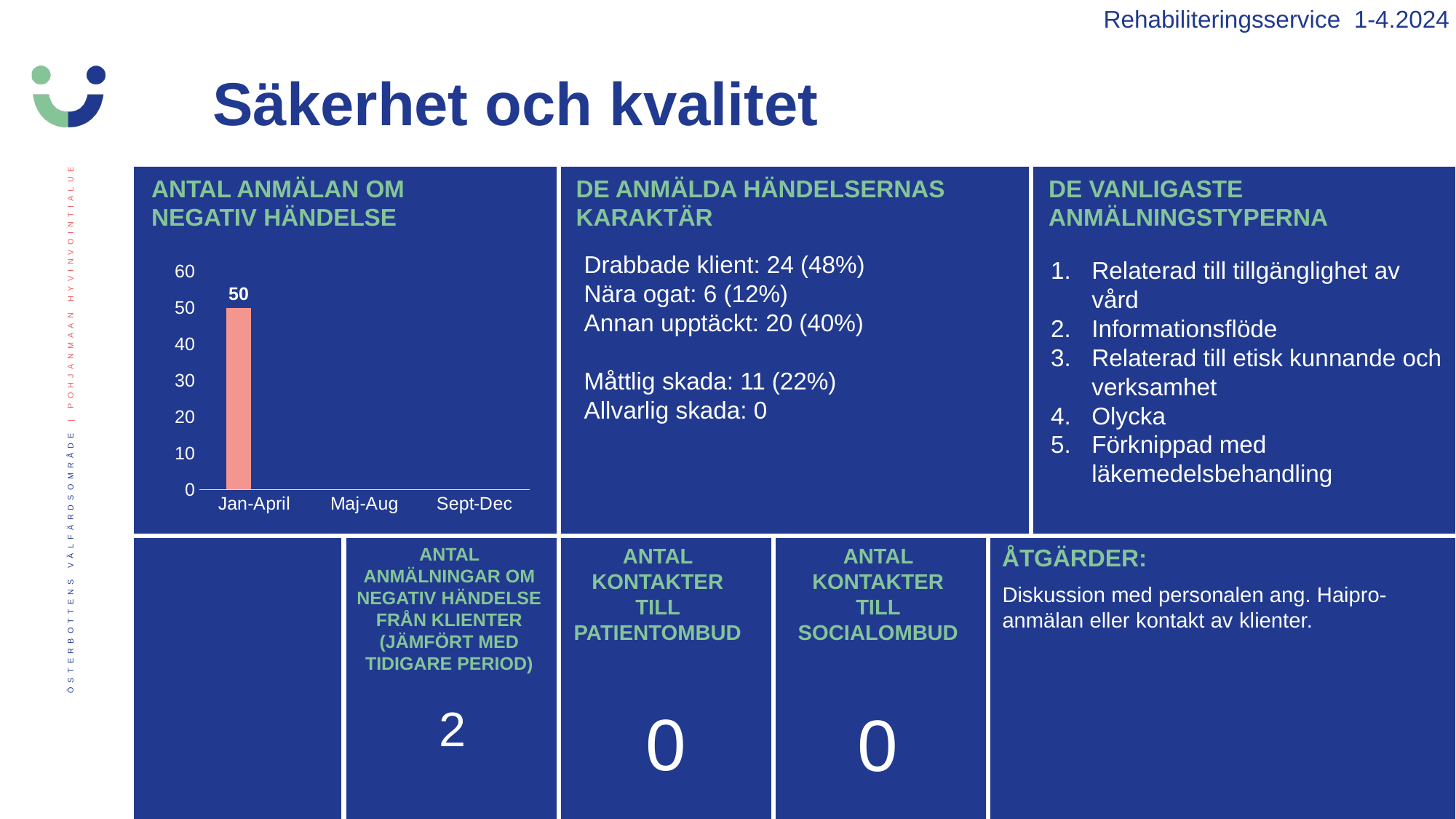
What is the highest value shown on the chart's y axis? 60 What is the value for Jan-April in the chart? 50 Is the value for Jan-April greater or less than 60? less Which category has the highest value in the chart? Jan-April What is the title of the chart? ANTAL ANMÄLAN OM NEGATIV HÄNDELSE What kind of chart is shown on the slide? bar chart Is the value for Jan-April greater or less than 40? greater Which categories on the x axis have no bar plotted? Maj-Aug and Sept-Dec How many categories are shown on the x axis of the chart? 3